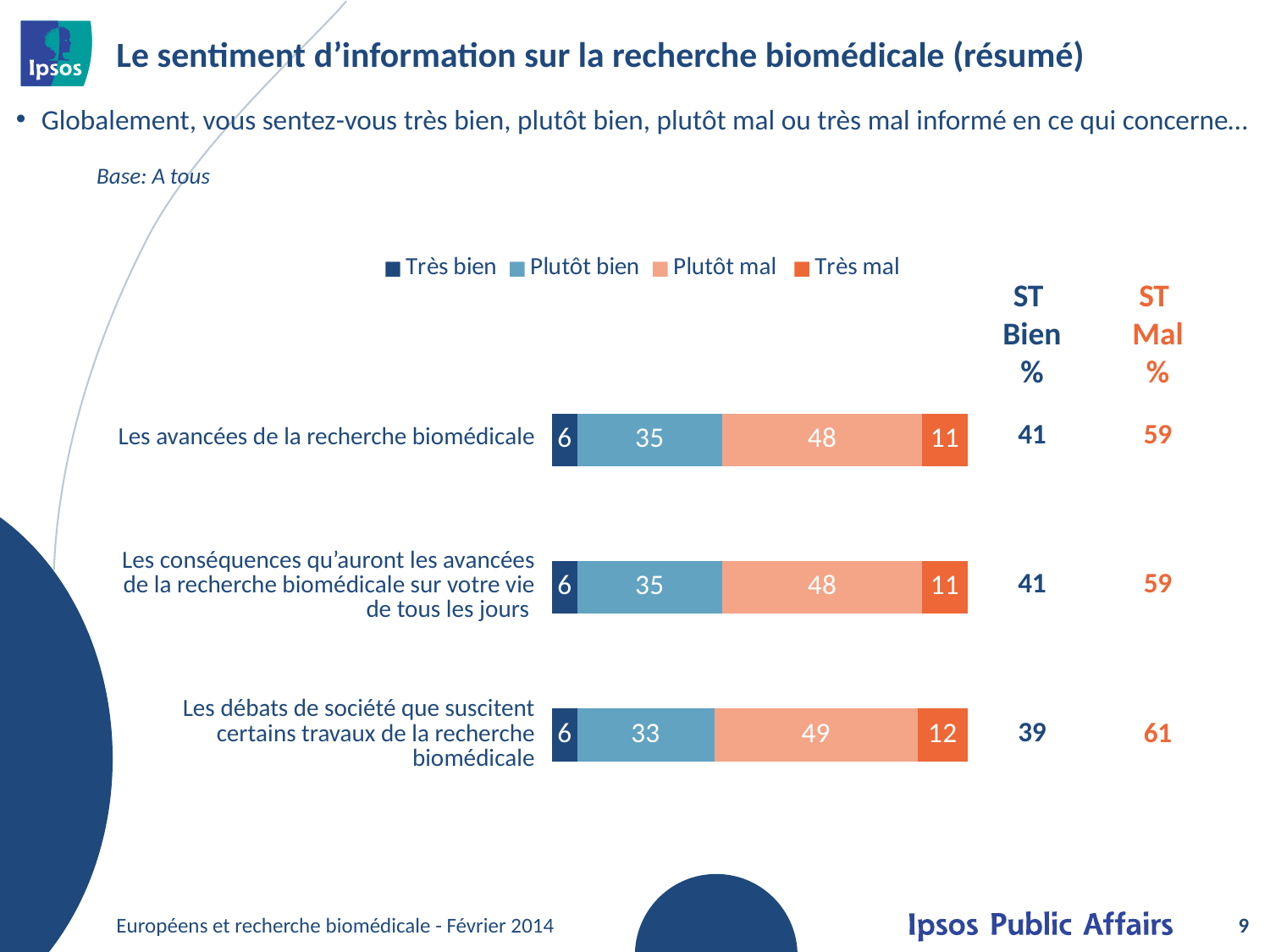
Which category has the highest "Plutôt mal" value? Les débats de société que suscitent certains travaux de la recherche biomédicale Which is larger for "Les débats de société que suscitent certains travaux de la recherche biomédicale": the "Plutôt bien" value or the "Plutôt mal" value? Plutôt mal What is the value for "Plutôt mal" for "Les avancées de la recherche biomédicale"? 48 What is the "ST Mal %" value shown for "Les débats de société que suscitent certains travaux de la recherche biomédicale"? 61 Which category has the lowest "Plutôt bien" value? Les débats de société que suscitent certains travaux de la recherche biomédicale What is the value for "Plutôt bien" for "Les conséquences qu'auront les avancées de la recherche biomédicale sur votre vie de tous les jours"? 35 What is the value for "Très mal" for "Les débats de société que suscitent certains travaux de la recherche biomédicale"? 12 How many series does the legend list? 4 What is the difference between the "Plutôt mal" and "Plutôt bien" values for "Les avancées de la recherche biomédicale"? 13 How many categories are plotted in the chart? 3 What kind of chart is shown on the slide? Stacked bar chart What is the total of the stacked bar for "Les débats de société que suscitent certains travaux de la recherche biomédicale"? 100